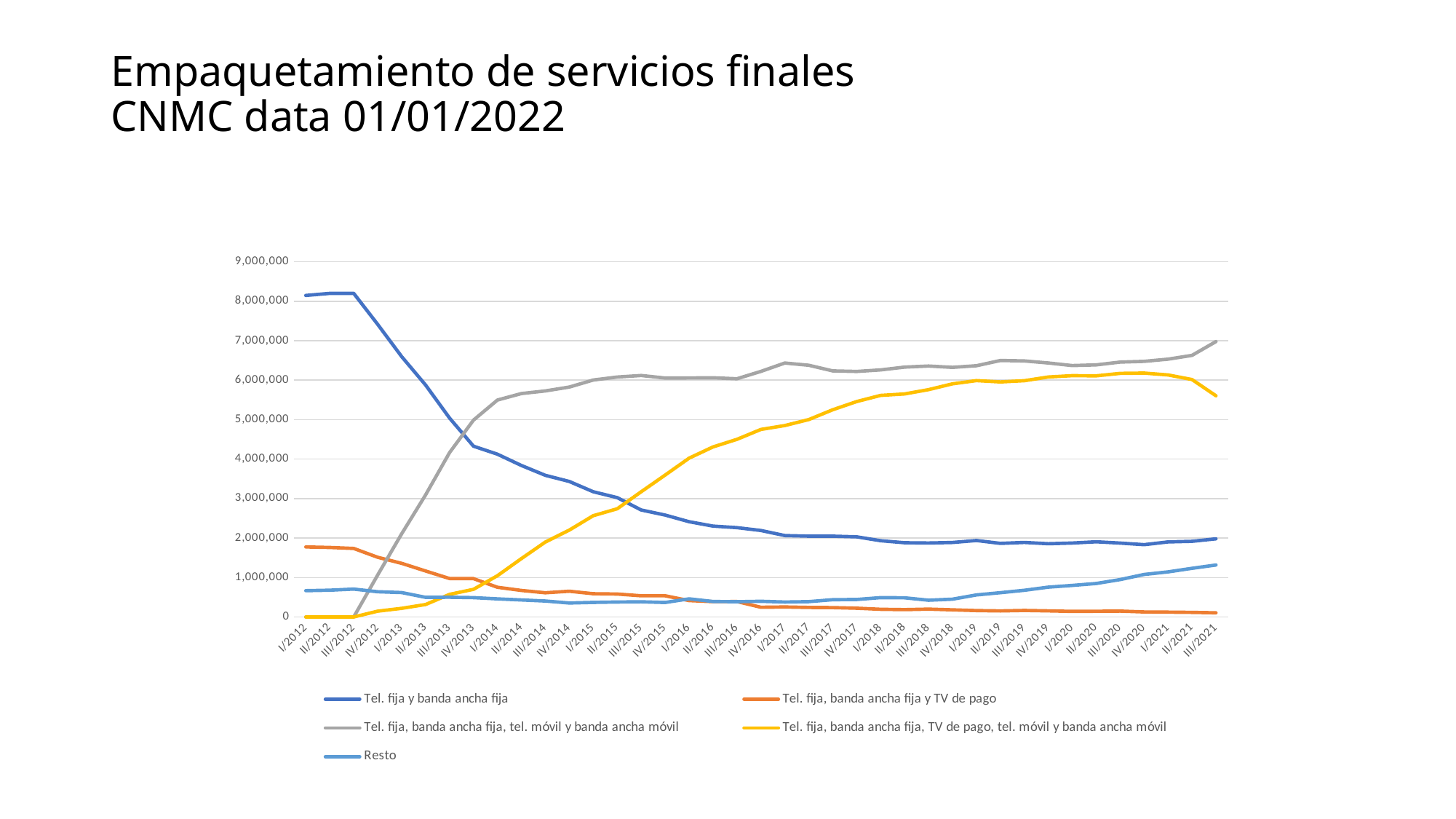
What is the highest value shown on the y axis? 9,000,000 Is the value for 'Tel. fija y banda ancha fija' at I/2012 greater or less than 8,000,000? greater What kind of chart is shown on the slide? line chart How many series does the legend list? 5 How many quarterly points are shown along the x axis, from I/2012 to III/2021? 39 Does the 'Tel. fija y banda ancha fija' series rise or fall from I/2012 to III/2021? fall Does the 'Tel. fija, banda ancha fija, TV de pago, tel. móvil y banda ancha móvil' series rise or fall from I/2012 to III/2021? rise Is the value for 'Resto' at III/2021 greater or less than 1,000,000? greater At III/2021, which is larger: 'Tel. fija, banda ancha fija, tel. móvil y banda ancha móvil' or 'Tel. fija, banda ancha fija, TV de pago, tel. móvil y banda ancha móvil'? Tel. fija, banda ancha fija, tel. móvil y banda ancha móvil Is the value for 'Tel. fija, banda ancha fija, tel. móvil y banda ancha móvil' at III/2021 greater or less than 6,000,000? greater Which series has the highest value at I/2012? Tel. fija y banda ancha fija